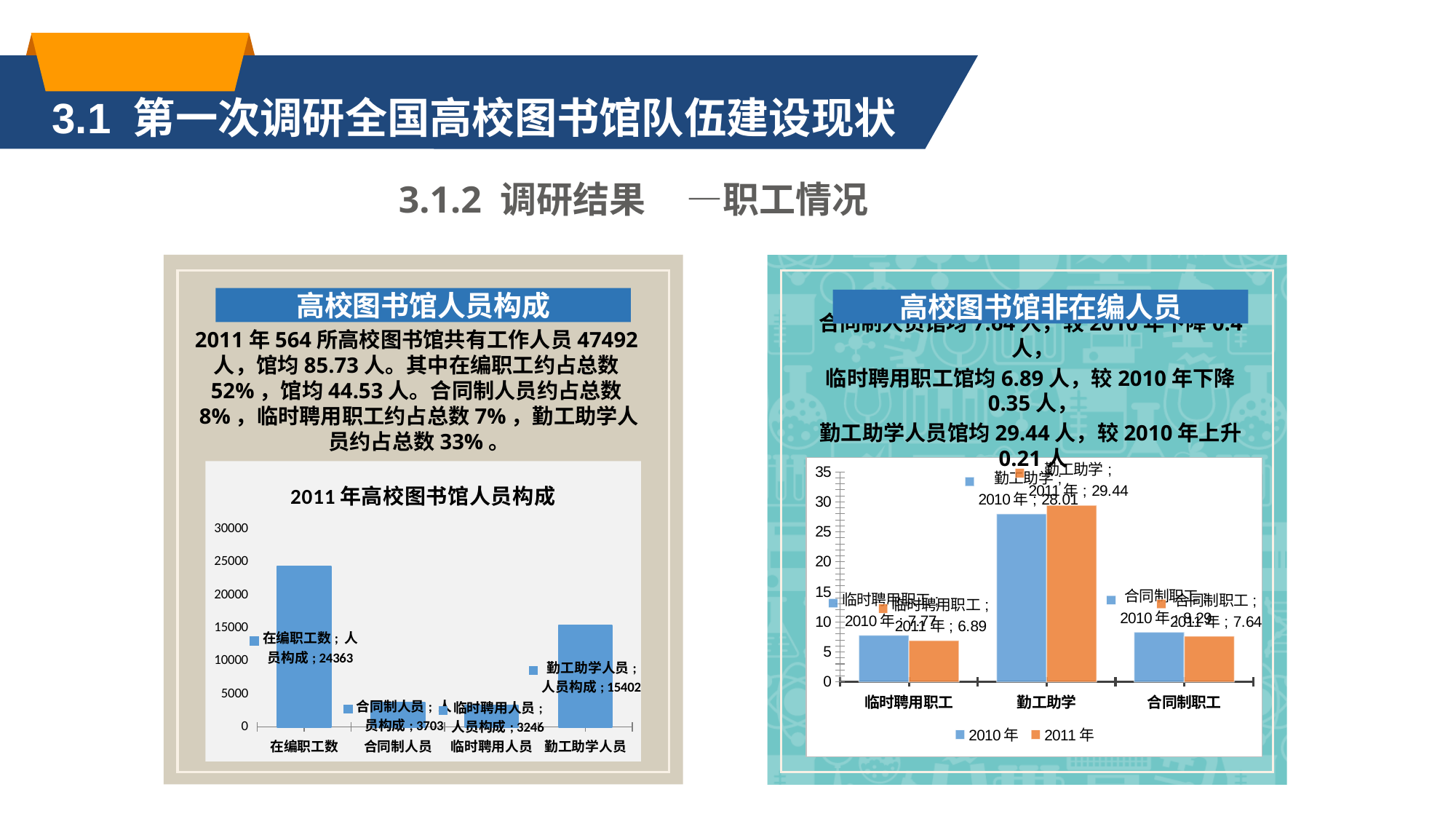
In the left chart titled 2011年高校图书馆人员构成, what is the difference between 合同制人员 and 临时聘用人员? 457 What kind of chart is the right chart under 高校图书馆非在编人员? bar chart In the right chart under 高校图书馆非在编人员, what is the 2011年 value for 勤工助学? 29.44 In the right chart under 高校图书馆非在编人员, how many series does the legend list? 2 In the right chart under 高校图书馆非在编人员, what is the difference between the 2011年 and 2010年 values for 勤工助学? 1.43 In the right chart under 高校图书馆非在编人员, which is larger for 临时聘用职工: the 2010年 value or the 2011年 value? 2010年 In the left chart titled 2011年高校图书馆人员构成, how many categories are shown on the x axis? 4 In the right chart under 高校图书馆非在编人员, what is the 2010年 value for 合同制职工? 8.29 In the left chart titled 2011年高校图书馆人员构成, what is the value for 在编职工数? 24363 In the left chart titled 2011年高校图书馆人员构成, which category has the lowest value? 临时聘用人员 In the left chart titled 2011年高校图书馆人员构成, which category has the highest value? 在编职工数 In the left chart titled 2011年高校图书馆人员构成, what is the value for 勤工助学人员? 15402